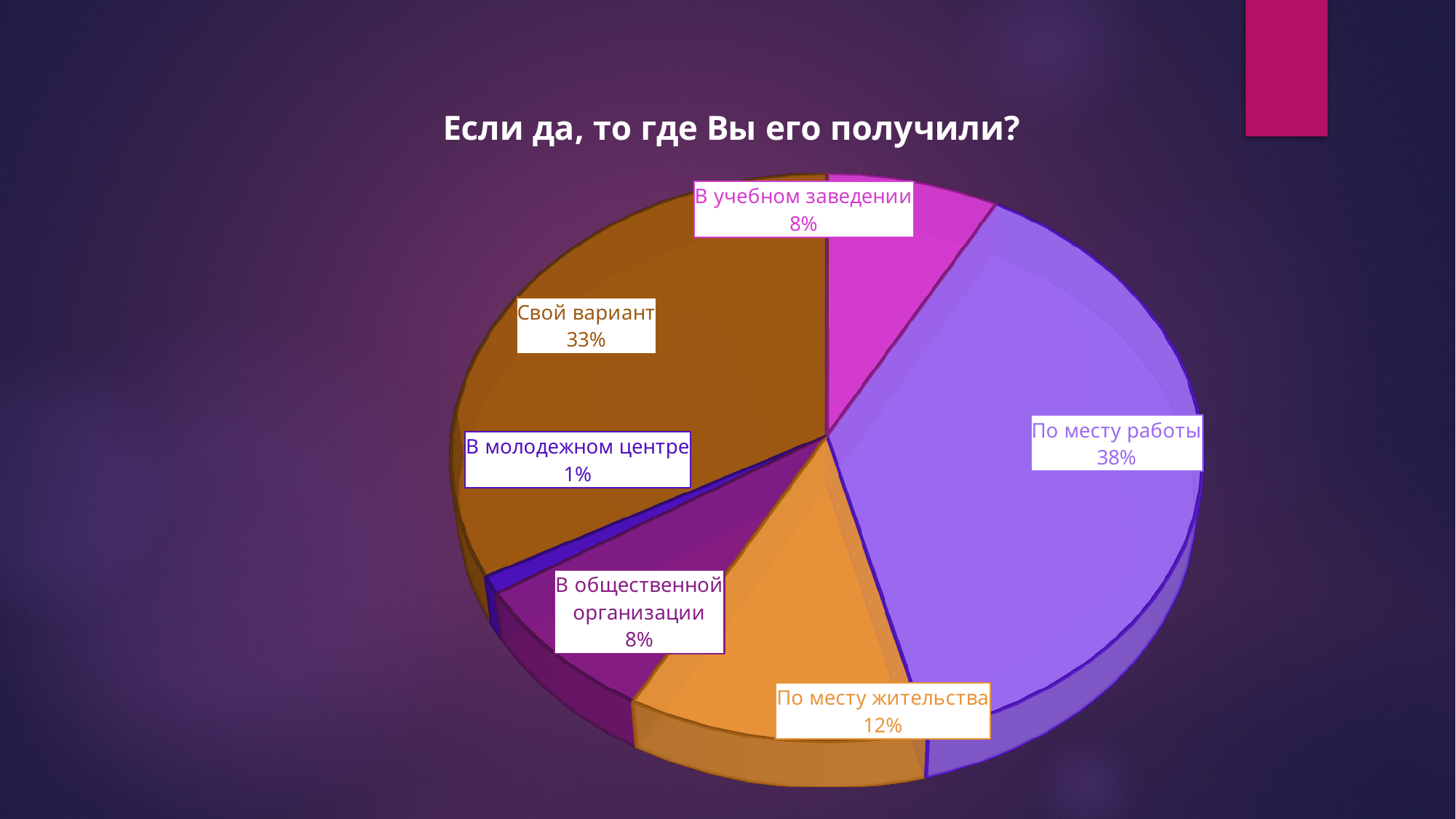
What share does "По месту работы" have? 38% Which category has the largest slice? По месту работы Which is larger, "По месту жительства" or "В общественной организации"? По месту жительства What is the difference in percentage points between "По месту работы" and "Свой вариант"? 5 What share does "В молодежном центре" have? 1% What is the title of the chart? Если да, то где Вы его получили? How many slices does the pie chart have? 6 What share does "По месту жительства" have? 12% What share does "В учебном заведении" have? 8% What kind of chart is shown on the slide? Pie chart What share does "Свой вариант" have? 33% Which category has the smallest slice? В молодежном центре